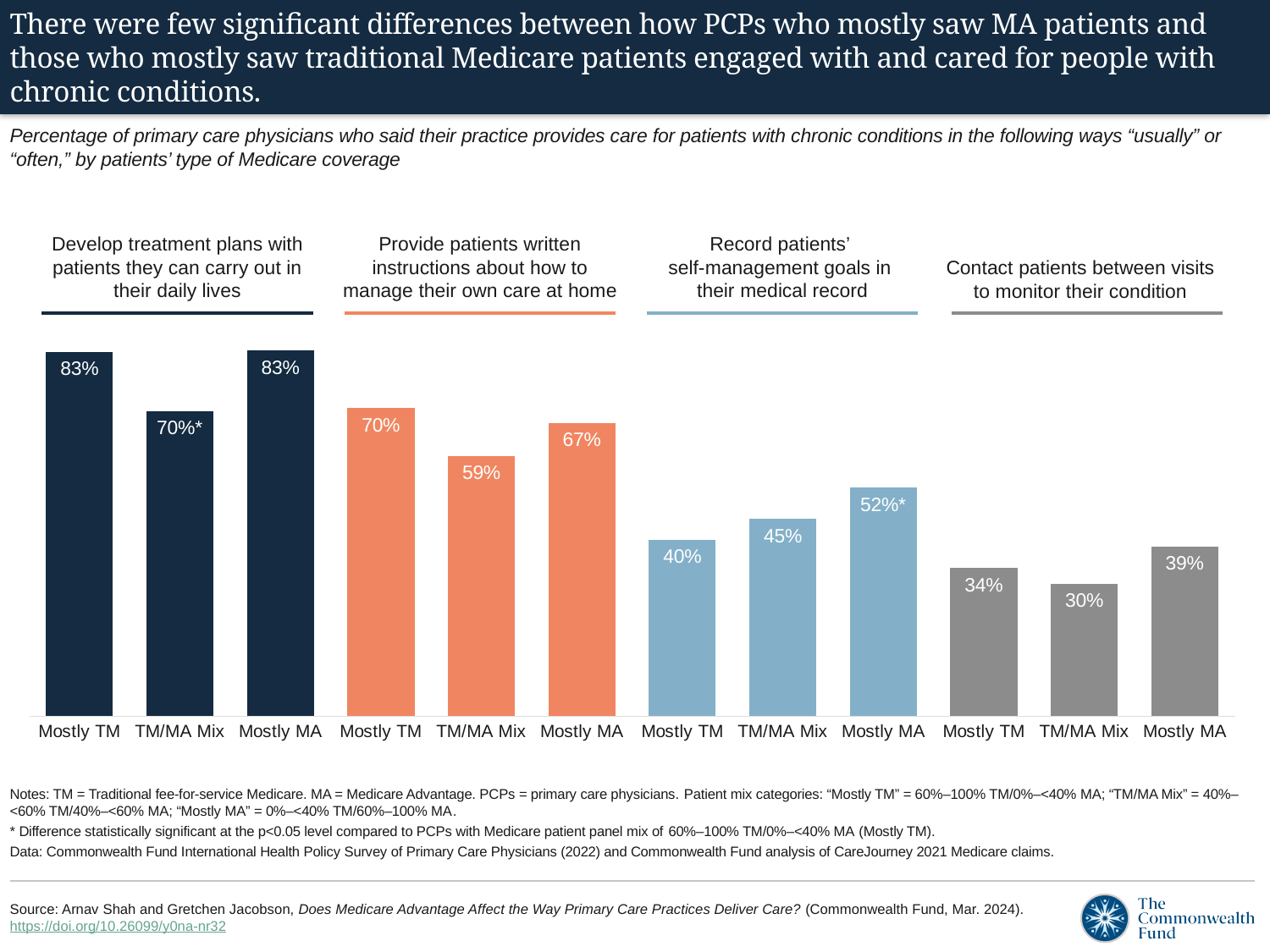
How many bars are in the 'Provide patients written instructions about how to manage their own care at home' chart? 3 In the 'Develop treatment plans with patients they can carry out in their daily lives' chart, what is the value for Mostly TM? 83% In the 'Record patients' self-management goals in their medical record' chart, what is the value for Mostly MA? 52%* In the 'Record patients' self-management goals in their medical record' chart, which category has the highest value? Mostly MA In the 'Record patients' self-management goals in their medical record' chart, which is larger, Mostly TM or TM/MA Mix? TM/MA Mix In the 'Provide patients written instructions about how to manage their own care at home' chart, what is the value for TM/MA Mix? 59% In the 'Develop treatment plans with patients they can carry out in their daily lives' chart, what is the value for TM/MA Mix? 70%* In the 'Record patients' self-management goals in their medical record' chart, do the values rise or fall from Mostly TM to Mostly MA? Rise What type of chart is used on this slide? Bar chart In the 'Provide patients written instructions about how to manage their own care at home' chart, what is the difference between Mostly TM and TM/MA Mix? 11 percentage points In the 'Contact patients between visits to monitor their condition' chart, what is the difference between Mostly MA and Mostly TM? 5 percentage points In the 'Contact patients between visits to monitor their condition' chart, which category has the lowest value? TM/MA Mix